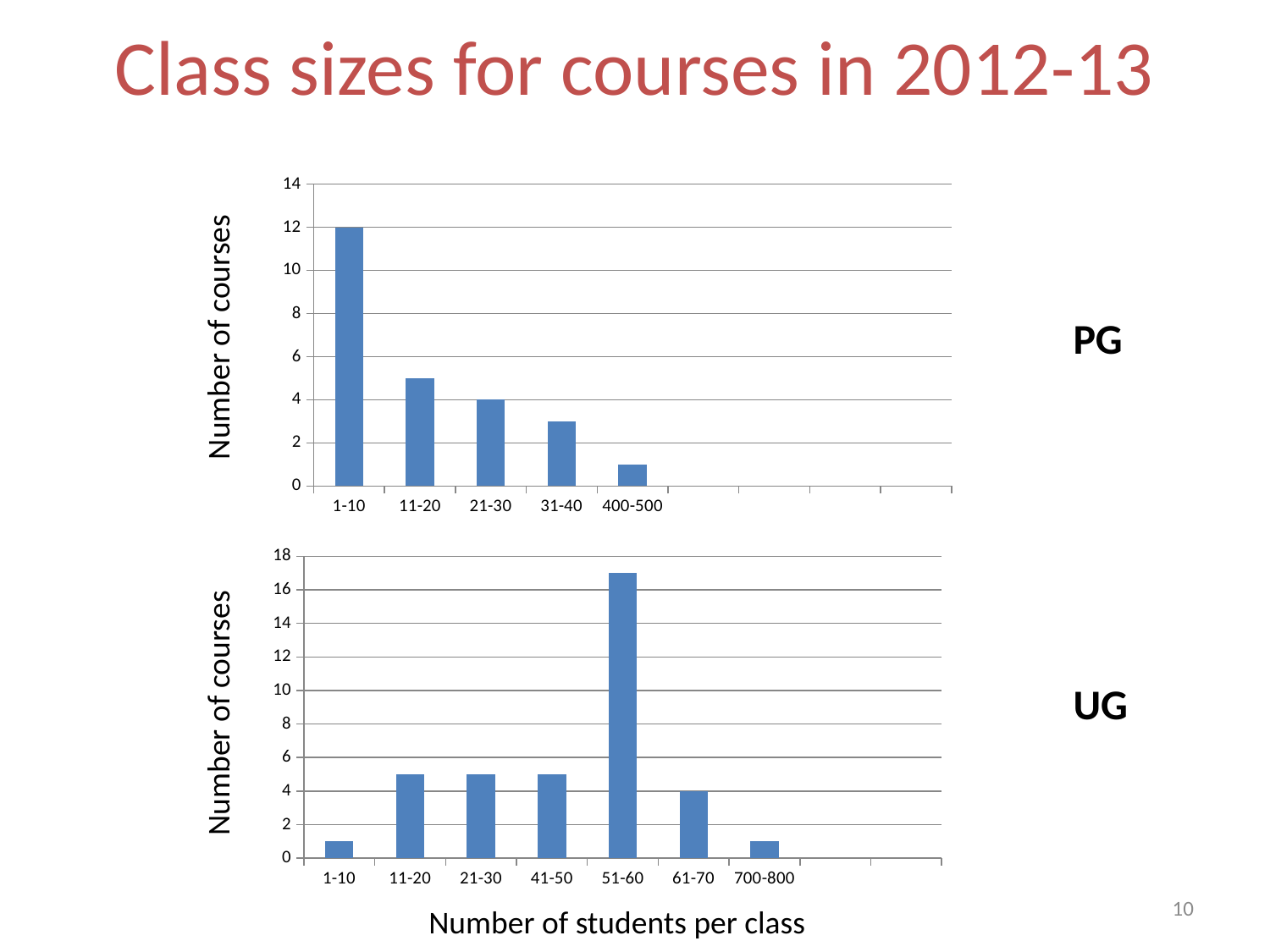
In the PG chart (top), is the number of courses with 11-20 students greater or less than 4? greater In the PG chart (top), what is the difference between the number of courses with 1-10 students and the number with 21-30 students? 8 In the UG chart (bottom), is the number of courses with 51-60 students greater or less than 16? greater In the PG chart (top), which class size category has the most courses? 1-10 In the PG chart (top), how many courses have 21-30 students per class? 4 In the UG chart (bottom), which has more courses: the 51-60 category or the 61-70 category? 51-60 In the UG chart (bottom), which class size category has the most courses? 51-60 In the PG chart (top), which class size category has the fewest courses? 400-500 How many class size categories have bars in the UG chart (bottom)? 7 In the UG chart (bottom), how many courses have 61-70 students per class? 4 In the PG chart (top), do the number of courses rise or fall as class size increases along the x axis? fall In the PG chart (top), how many courses have 1-10 students per class? 12